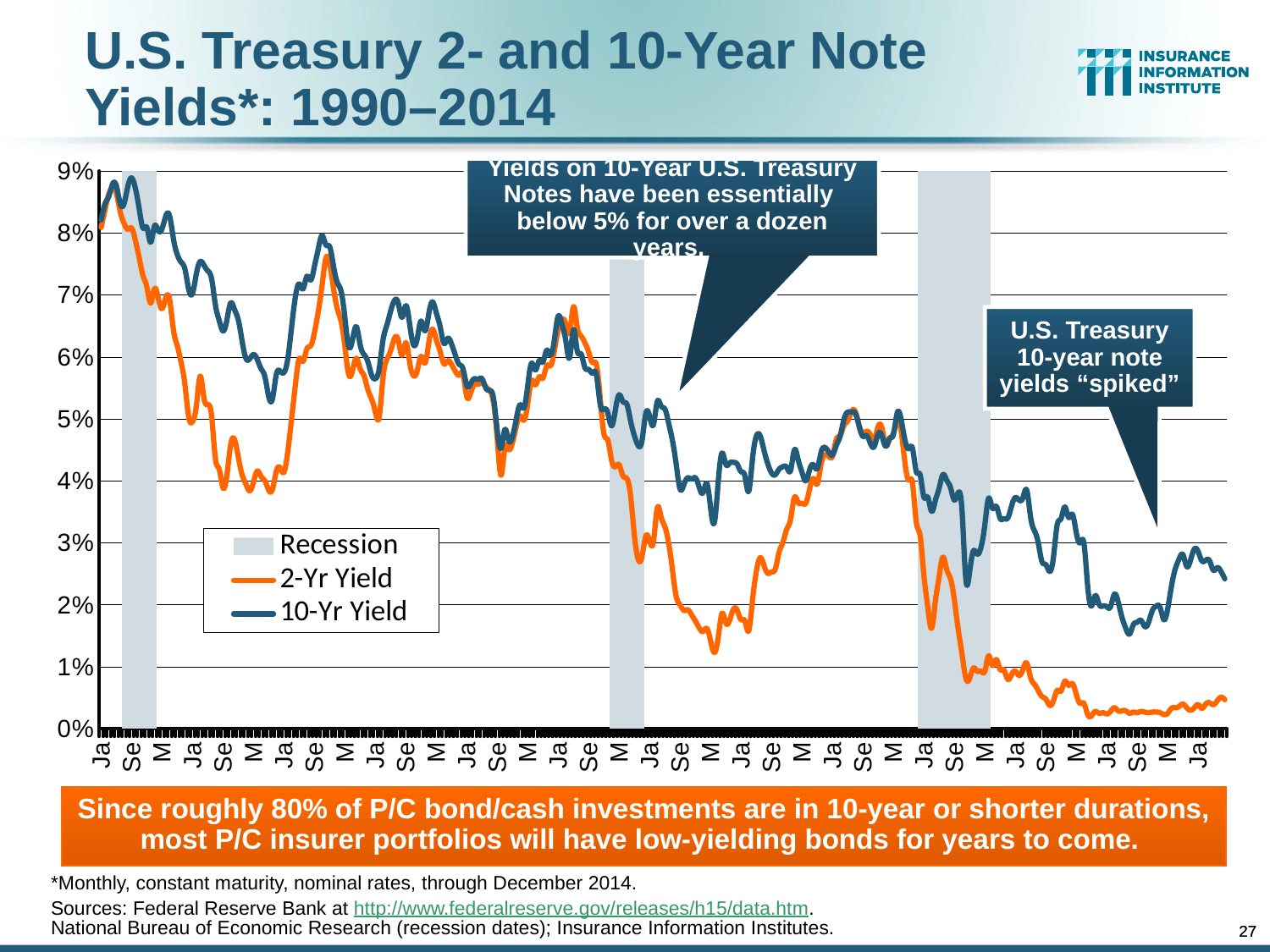
What are the two yield series plotted on the chart? 2-Yr Yield and 10-Yr Yield Is the highest value reached by the 10-Yr Yield greater or less than 8%? greater At the right end of the chart, which series is higher, the 2-Yr Yield or the 10-Yr Yield? 10-Yr Yield Is the 10-Yr Yield at the right end of the chart greater or less than 3%? less Is the 2-Yr Yield at the right end of the chart greater or less than 1%? less What is the highest value shown on the chart's vertical axis? 9% Over the full period shown, do the Treasury yields generally rise or fall from left to right? Fall What is the title of the chart on the slide? U.S. Treasury 2- and 10-Year Note Yields*: 1990–2014 Which series reaches the lowest value anywhere on the chart? 2-Yr Yield What kind of chart is shown on the slide? Line chart How many entries does the chart legend list? 3